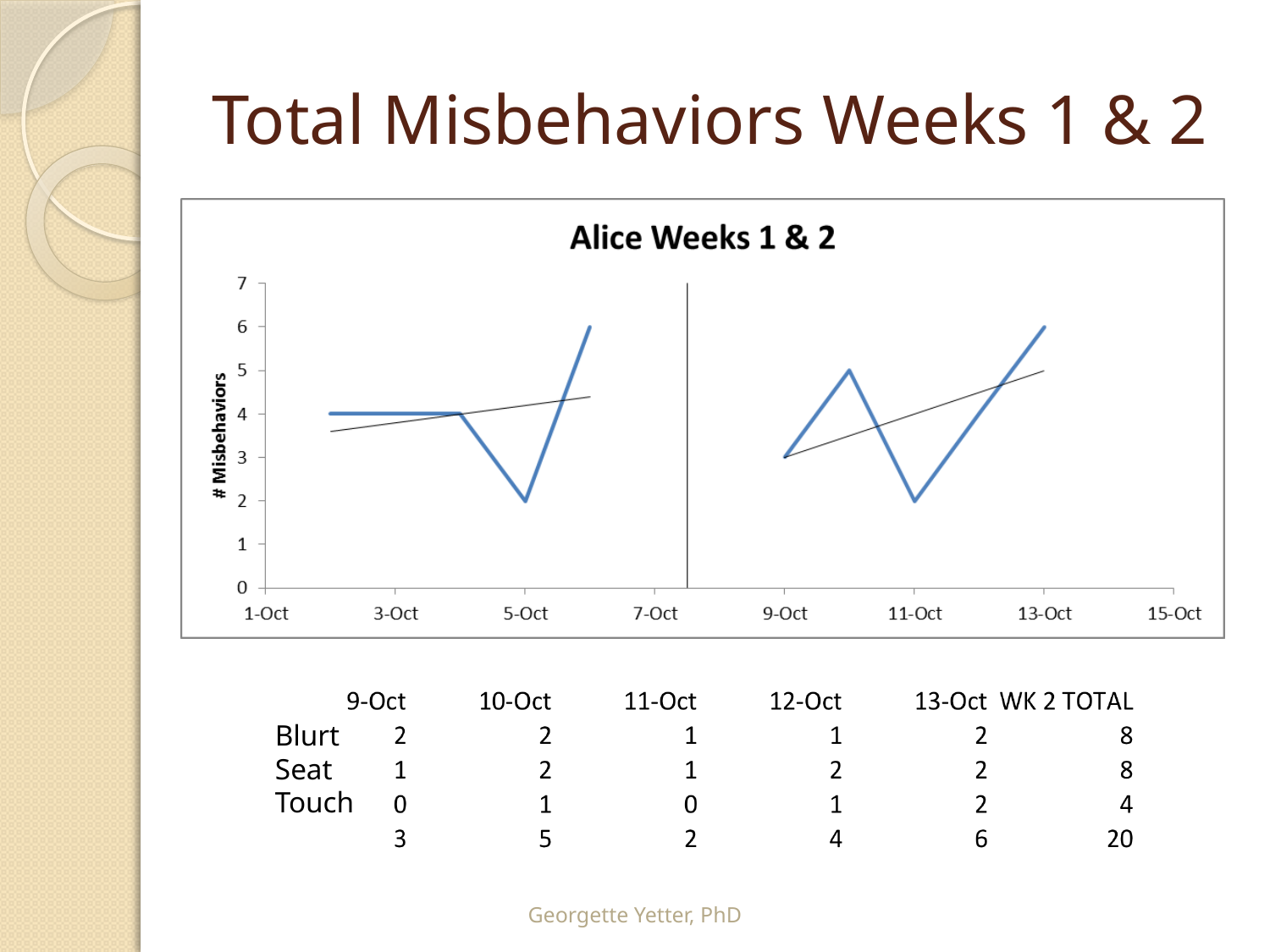
Which date has more misbehaviors, 9-Oct or 11-Oct? 9-Oct In week 2 (9-Oct to 13-Oct), which date has the highest number of misbehaviors? 13-Oct What is the difference between the misbehaviors on 13-Oct and on 11-Oct? 4 What kind of chart is shown on the slide? line chart In week 2 (9-Oct to 13-Oct), which date has the lowest number of misbehaviors? 11-Oct What is the label on the vertical axis of the chart? # Misbehaviors How many misbehaviors are plotted for 9-Oct? 3 What is the title of the chart? Alice Weeks 1 & 2 How many misbehaviors are plotted for 11-Oct? 2 How many misbehaviors are plotted for 13-Oct? 6 How many misbehaviors are plotted for 5-Oct? 2